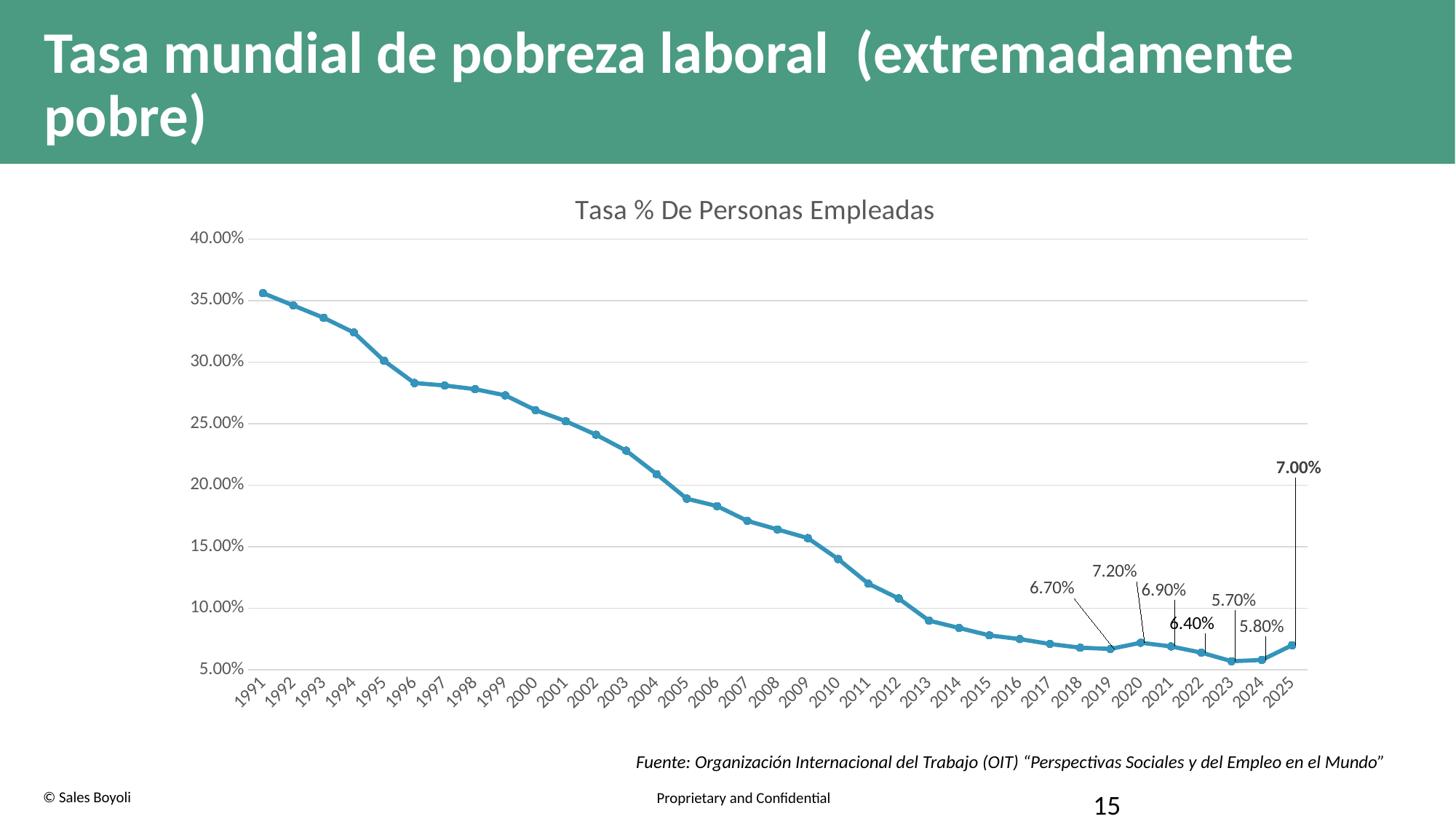
Do the values generally rise or fall from 1991 to 2025? fall What is the value for 2019? 6.70% How many years are plotted on the x axis? 35 What is the difference between the values for 2020 and 2023? 1.50% What is the value for 2023? 5.70% What is the value for 2020? 7.20% Which year has the highest value? 1991 Is the value for 1995 greater or less than 25.00%? greater What is the value for 2025? 7.00% What is the difference between the values for 2025 and 2024? 1.20% Which is larger, the value for 2021 or the value for 2022? 2021 What kind of chart is shown on the slide? line chart